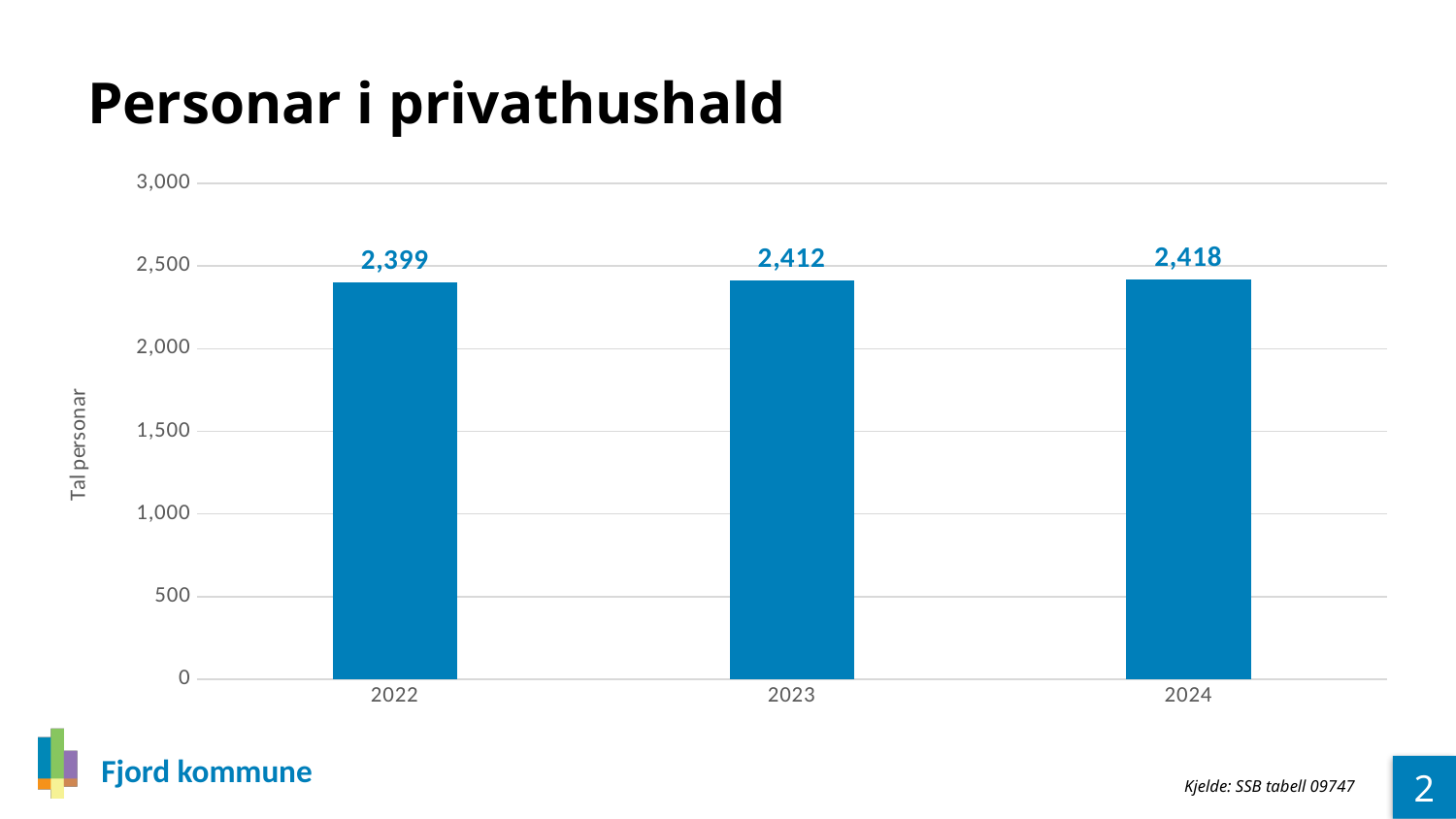
What is the value for 2022? 2,399 What is the value for 2023? 2,412 Which is larger, the value for 2023 or the value for 2024? 2024 What kind of chart is shown on the slide? bar chart Do the values rise or fall from 2022 to 2024? rise How many years are shown on the x axis? 3 What is the difference between the values for 2023 and 2022? 13 What is the value for 2024? 2,418 Is the value for 2022 greater or less than 2,500? less What is the difference between the values for 2024 and 2022? 19 Which year has the highest value? 2024 Which year has the lowest value? 2022